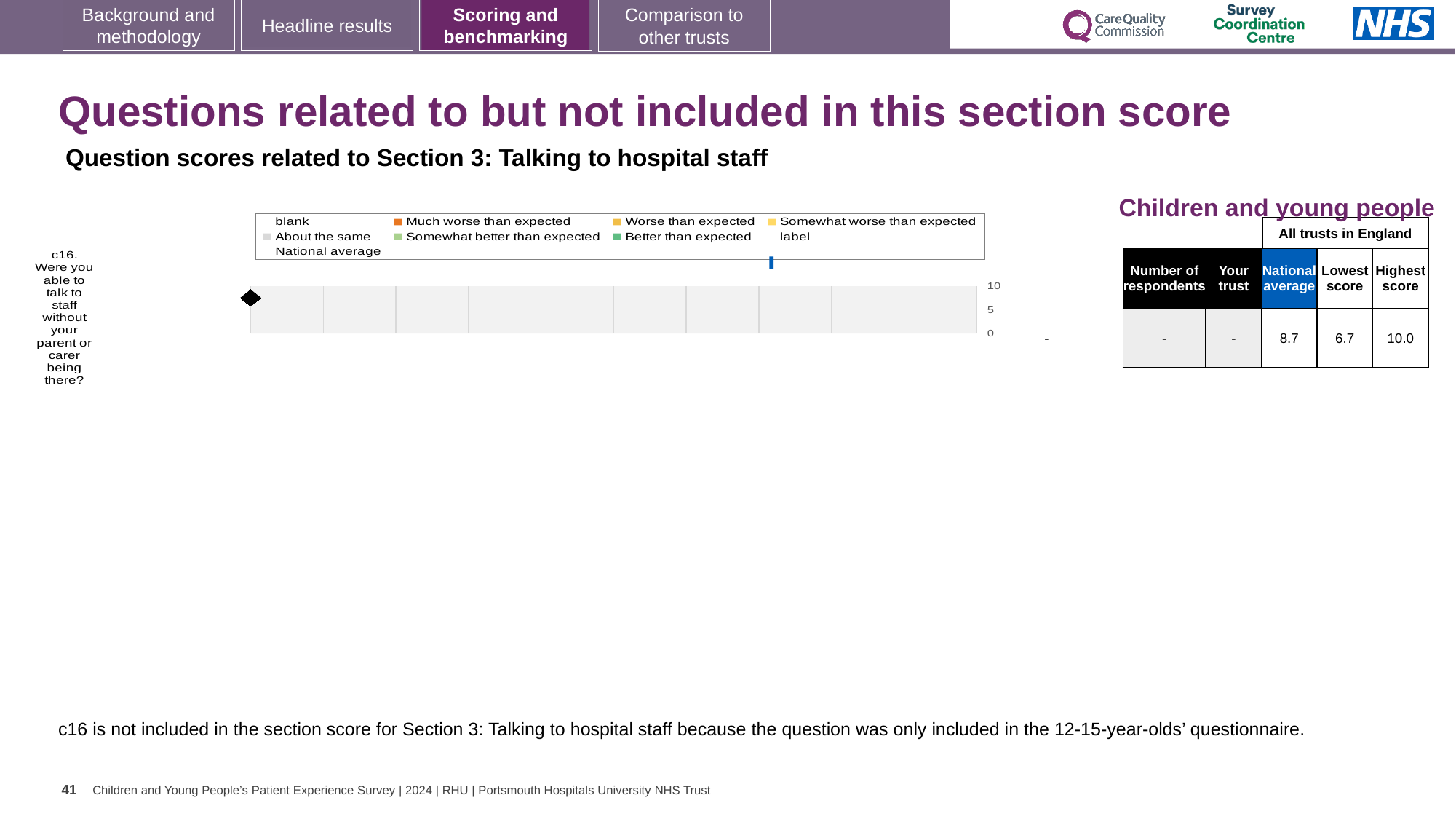
In the Children and young people table, what is the Lowest score for c16? 6.7 What kind of chart is shown for question c16? bar chart In the Children and young people table, what is the difference between the National average and the Lowest score for c16? 2.0 How many survey questions are plotted in the chart? 1 In the Children and young people table, what is the difference between the Highest score and the Lowest score for c16? 3.3 What is the highest value shown on the chart's score axis? 10 Is the National average score for c16 greater or less than 5? greater Which question is plotted in the chart? c16. Were you able to talk to staff without your parent or carer being there? In the Children and young people table, what is the Your trust score for c16? - In the Children and young people table, which is larger for c16: the National average or the Lowest score? National average In the Children and young people table, what is the Highest score for c16? 10.0 In the Children and young people table, what is the National average score for c16? 8.7